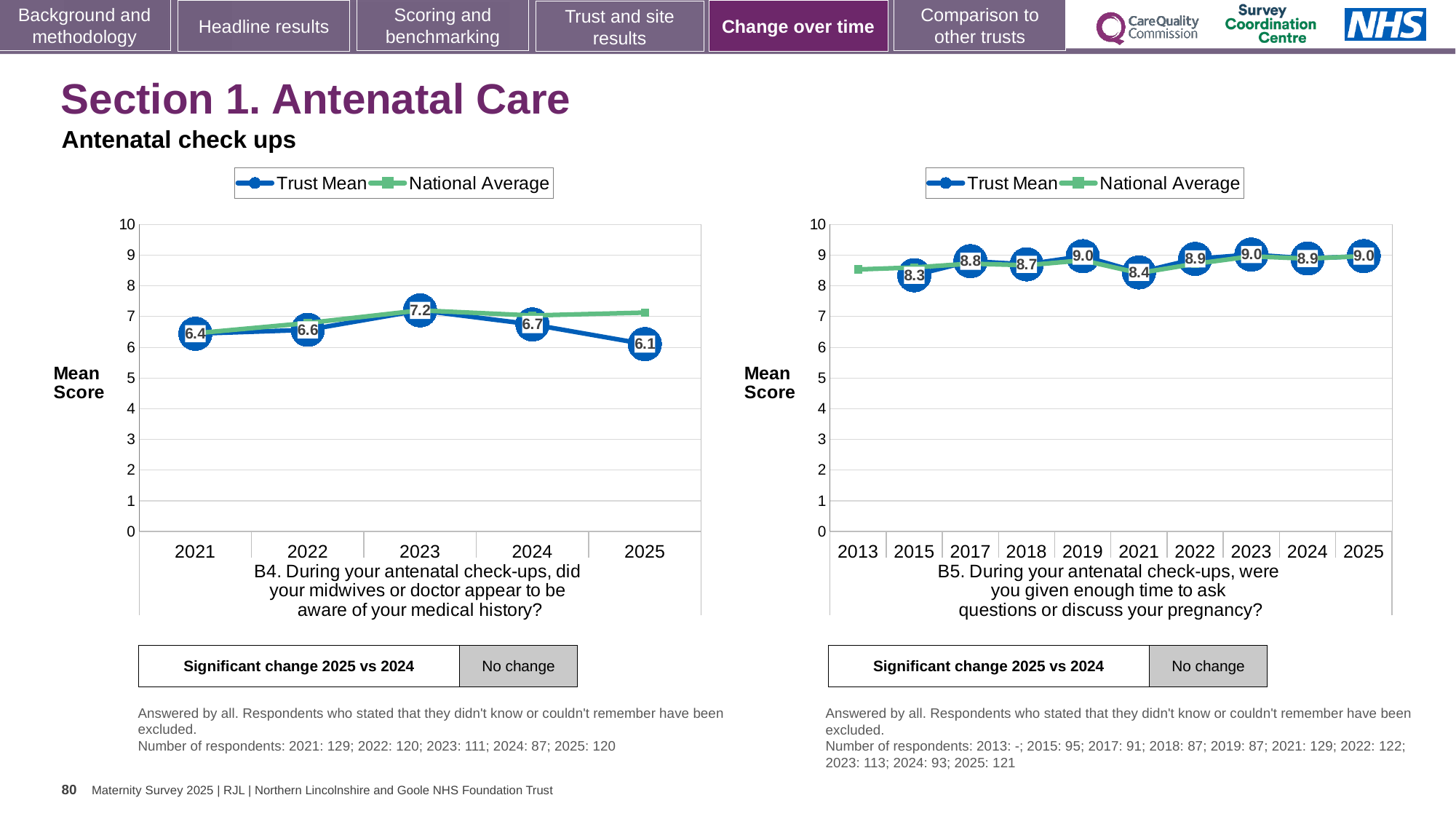
On the right chart (B5), which year has the lowest Trust Mean score? 2015 On the right chart (B5), how many years are shown on the x axis? 10 On the right chart (B5), what is the Trust Mean score for 2021? 8.4 On the left chart (B4), what is the difference between the Trust Mean scores for 2023 and 2025? 1.1 On the left chart (B4), which year has the lowest Trust Mean score? 2025 On the left chart (B4), is the National Average for 2021 greater or less than 7? less On the right chart (B5), which is larger, the Trust Mean score for 2021 or for 2022? 2022 On the left chart (B4), which year has the highest Trust Mean score? 2023 What kind of chart is the right chart (B5)? line chart On the left chart (B4), what is the Trust Mean score for 2023? 7.2 On the left chart (B4), what is the Trust Mean score for 2025? 6.1 On the left chart (B4), how many series does the legend list? 2